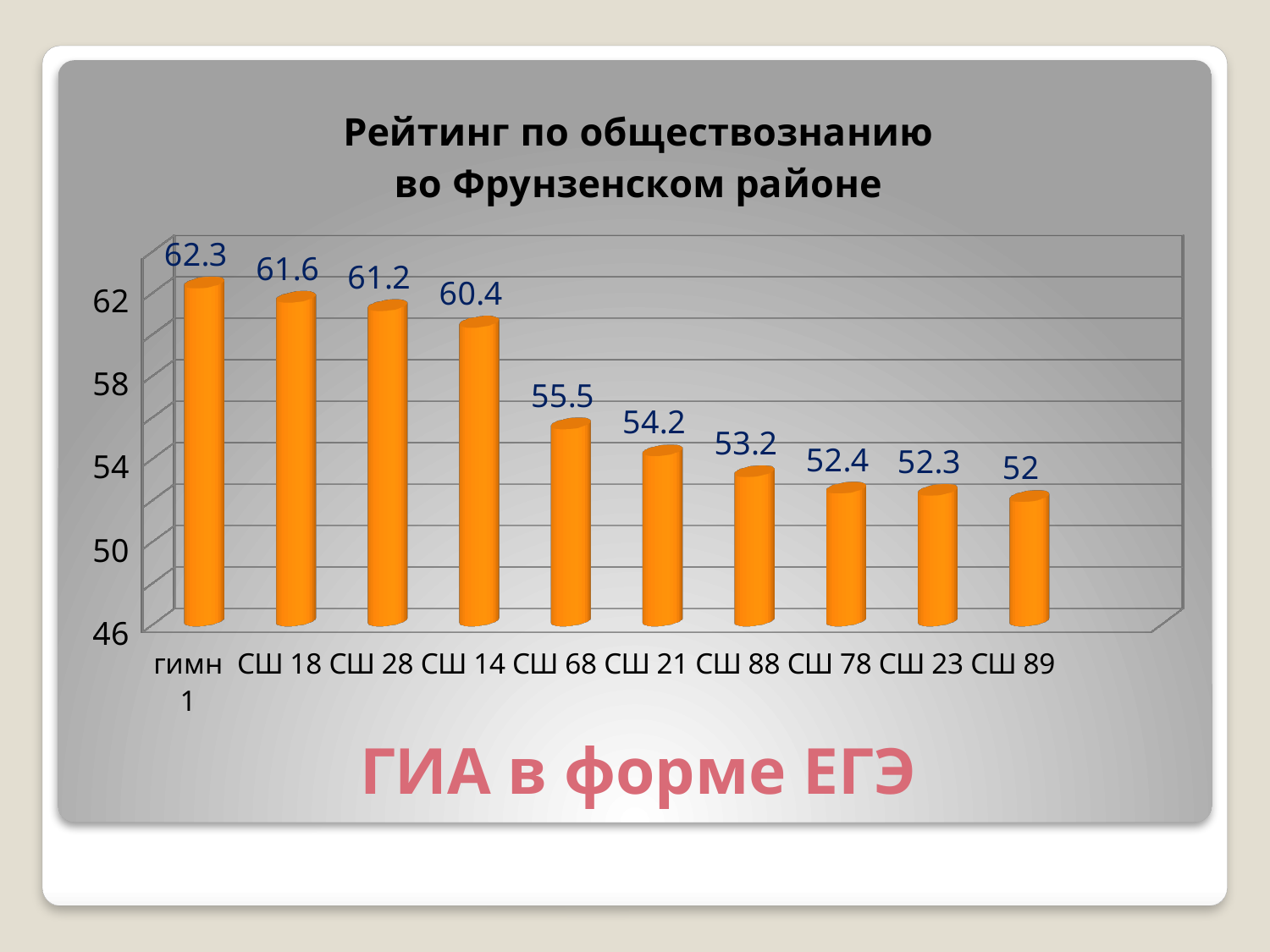
Which category has the lowest value? СШ 89 What is the difference between the values for СШ 18 and СШ 21? 7.4 Do the values rise or fall from left to right along the x axis? fall Is the value for СШ 28 greater or less than 58? greater What is the value for СШ 68? 55.5 What kind of chart is shown on the slide? bar chart Which is larger, the value for СШ 14 or the value for СШ 88? СШ 14 How many categories are shown on the x axis? 10 What is the value for СШ 78? 52.4 Which category has the highest value? гимн 1 What is the value for гимн 1? 62.3 What is the title of the chart? Рейтинг по обществознанию во Фрунзенском районе